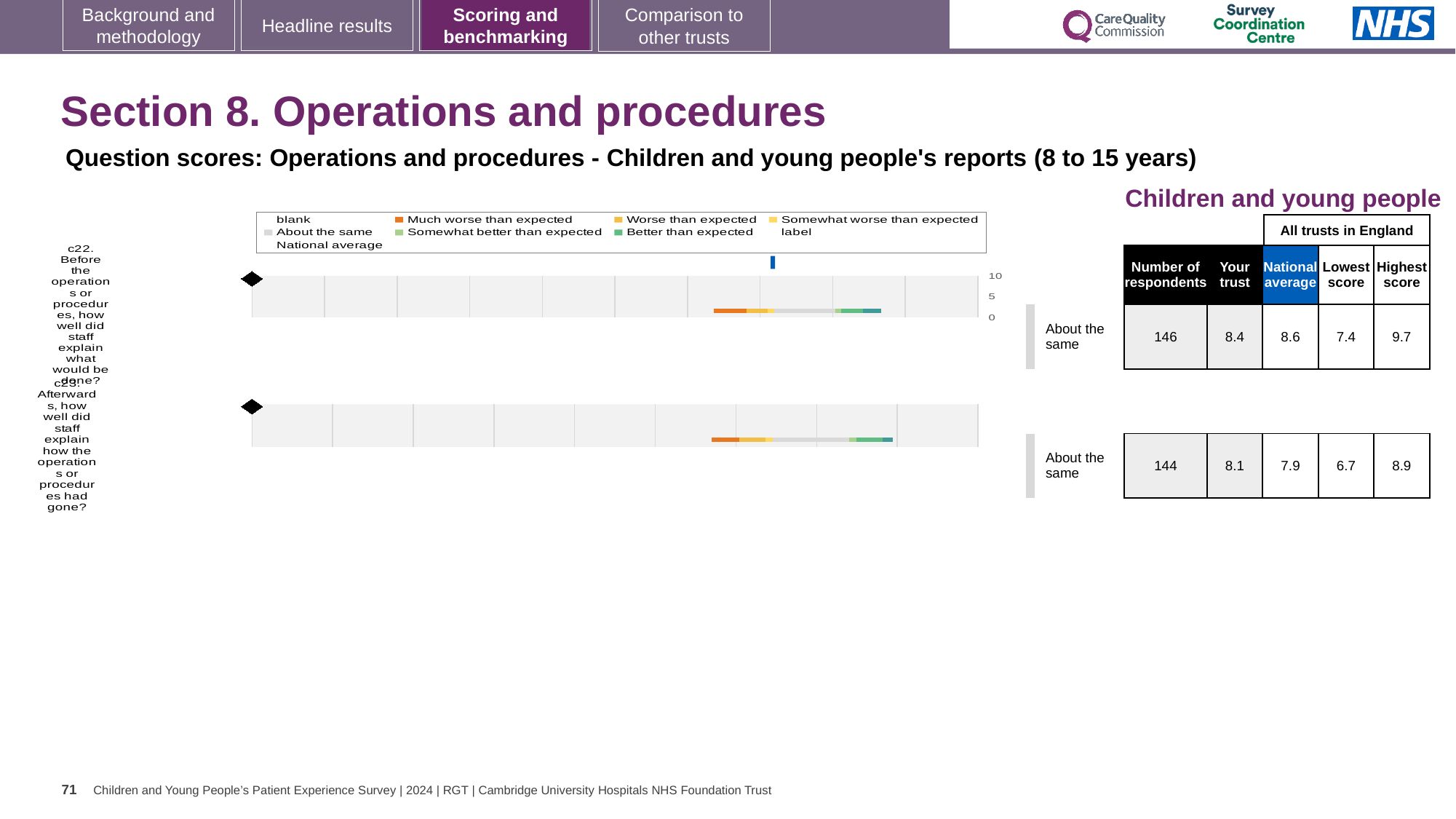
What is the 'Your trust' score for c22 (Before the operations or procedures, how well did staff explain what would be done?)? 8.4 For c22, which is larger: the 'Your trust' score or the National average? National average What kind of chart is used to show the question scores for c22 and c23? bar chart How many respondents answered c22? 146 Which legend entry is shown in orange? Much worse than expected What is the National average score for c23 (Afterwards, how well did staff explain how the operations or procedures had gone?)? 7.9 How many questions (c22 and c23) are plotted as bars on the slide? 2 What benchmark category is shown for c23? About the same What is the heading above the National average, Lowest score and Highest score columns? All trusts in England For c22, what is the difference between the Highest score and the Lowest score? 2.3 For c23, what is the difference between the Highest score and the Lowest score? 2.2 Which question has the higher 'Your trust' score, c22 or c23? c22